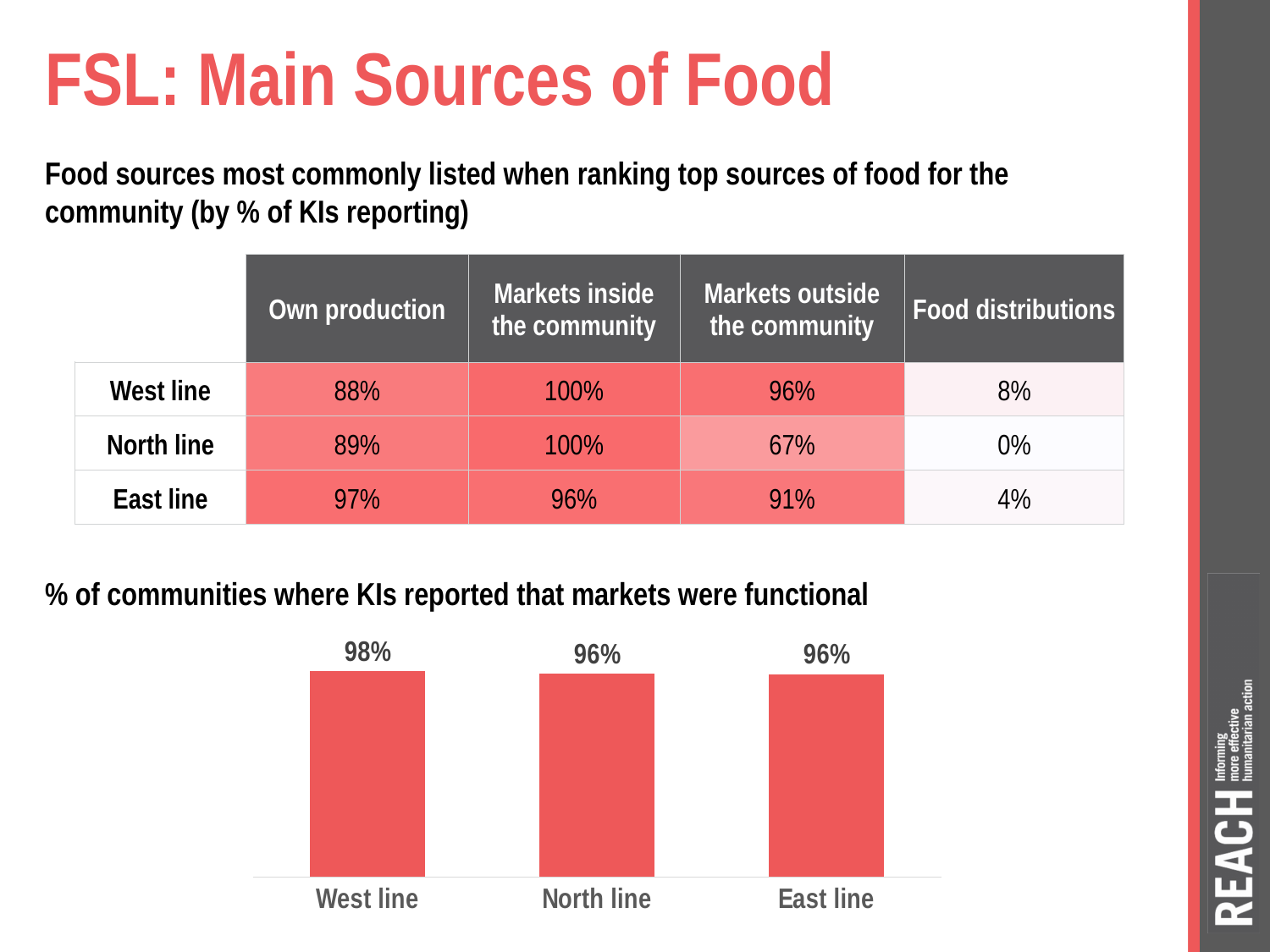
How many bars are shown in the bar chart at the bottom of the slide? 3 What type of chart is used to show the % of communities where KIs reported that markets were functional? bar chart In the bar chart, what is the value shown for East line? 96% What is the title of the bar chart at the bottom of the slide? % of communities where KIs reported that markets were functional Which line has the highest value in the bar chart of communities where markets were reported functional? West line In the bar chart, what percentage of communities on the North line had KIs report that markets were functional? 96% In the bar chart, is the value for West line larger or smaller than the value for East line? larger What are the category labels along the x axis of the bar chart? West line, North line, East line In the bar chart, what is the difference between the West line value and the North line value? 2% What is the value for West line in the bar chart showing the % of communities where KIs reported that markets were functional? 98% In the bar chart, do the values for North line and East line differ? No, both are 96%